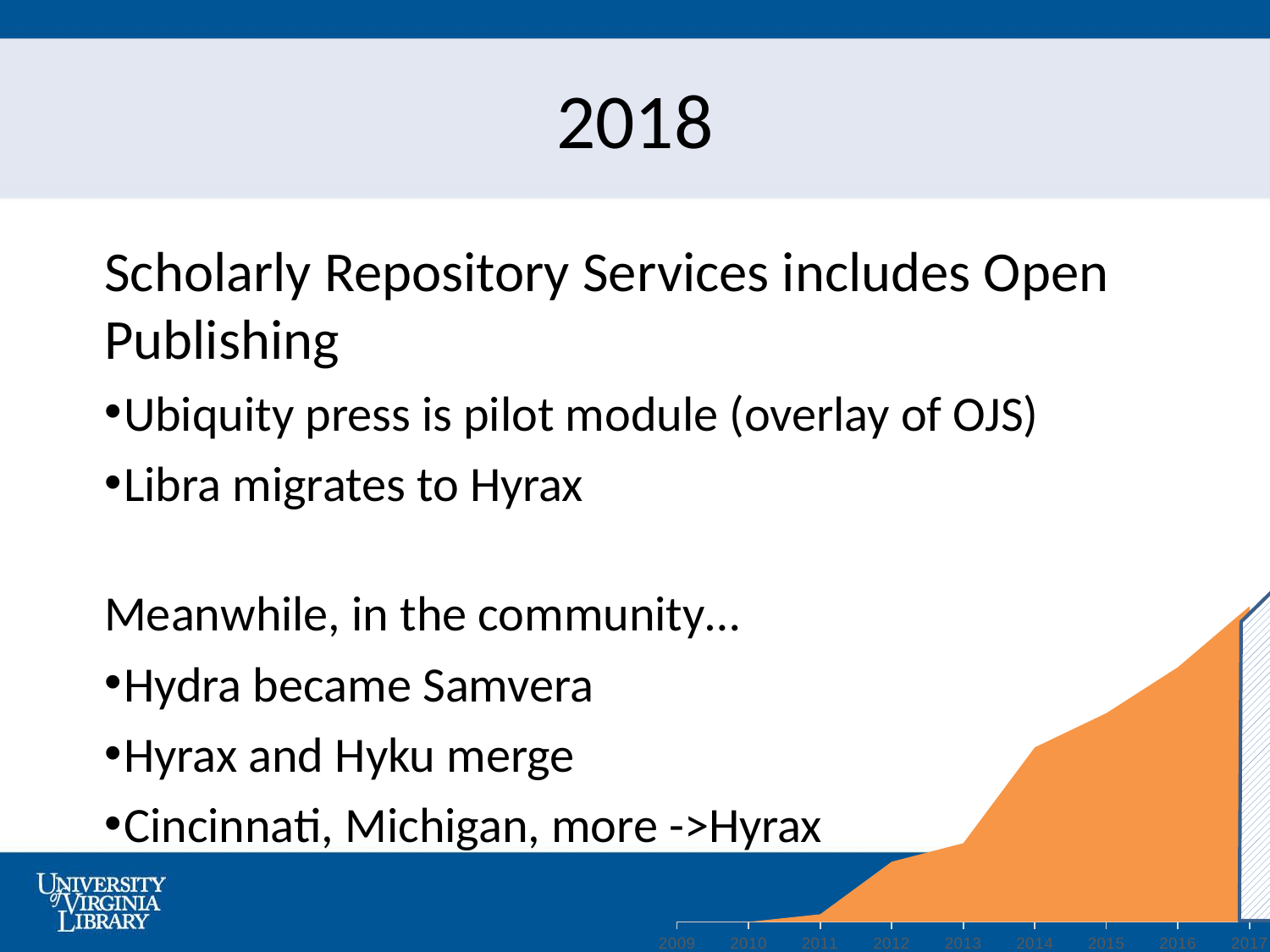
In the chart at the bottom right, which is larger, the value for 2013 or the value for 2011? 2013 In the chart at the bottom right, which year has the lowest value? 2009 and 2010 (tied at zero) How many years are labelled on the x axis of the chart at the bottom right? 9 In the chart at the bottom right, which is larger, the value for 2016 or the value for 2012? 2016 In the chart at the bottom right, do the values rise or fall from 2009 to 2017? rise What kind of chart is shown at the bottom right of the slide? area chart In the chart at the bottom right, which is larger, the value for 2015 or the value for 2010? 2015 What is the first year shown on the x axis of the chart at the bottom right? 2009 What colour is the main filled area in the chart at the bottom right? orange